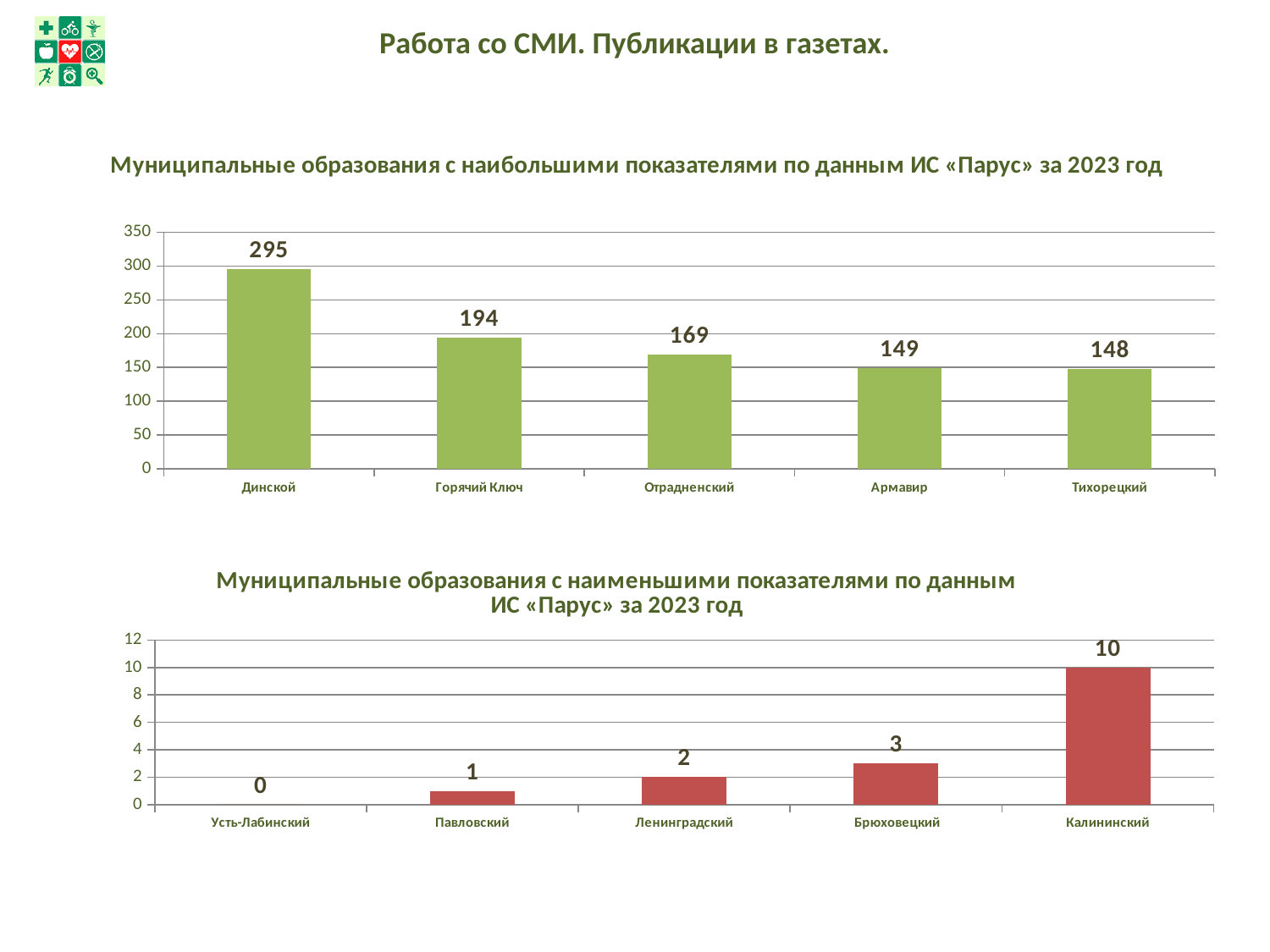
In the bottom chart (smallest indicators), what is the value for Калининский? 10 In the top chart (largest indicators), what is the difference between Динской and Горячий Ключ? 101 In the top chart (largest indicators), do the values rise or fall from left to right? fall In the bottom chart (smallest indicators), what is the difference between Калининский and Брюховецкий? 7 In the top chart (largest indicators), what is the value for Динской? 295 What kind of chart is the bottom chart (smallest indicators)? bar chart In the top chart (largest indicators), how many municipalities are shown? 5 In the bottom chart (smallest indicators), which municipality has the lowest value? Усть-Лабинский What colour are the bars in the bottom chart (smallest indicators)? red In the bottom chart (smallest indicators), which is larger, Брюховецкий or Ленинградский? Брюховецкий In the top chart (largest indicators), what is the value for Армавир? 149 In the top chart (largest indicators), which municipality has the highest value? Динской